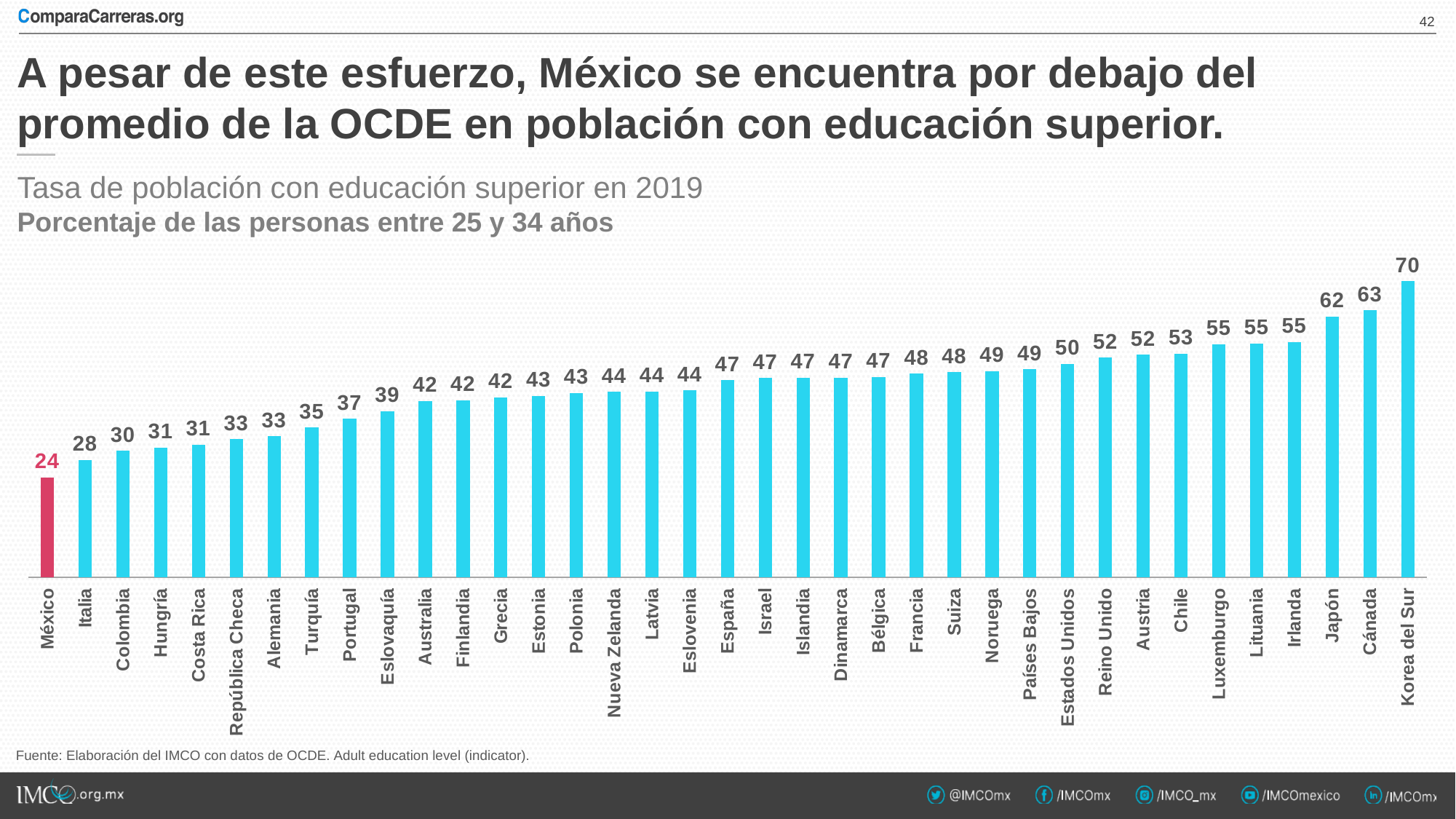
What is the difference between the values for Japón and Cánada? 1 What is the value for Korea del Sur? 70 Which country has the highest value? Korea del Sur Which bar is shown in a different colour (red) from the rest? México What is the value for Estados Unidos? 50 What is the difference between the values for Korea del Sur and México? 46 How many countries are shown in the chart? 37 What kind of chart is shown on the slide? Bar chart Which country has the lowest value? México What is the value for Chile? 53 What is the value for México? 24 Which has a larger value, Turquía or Portugal? Portugal